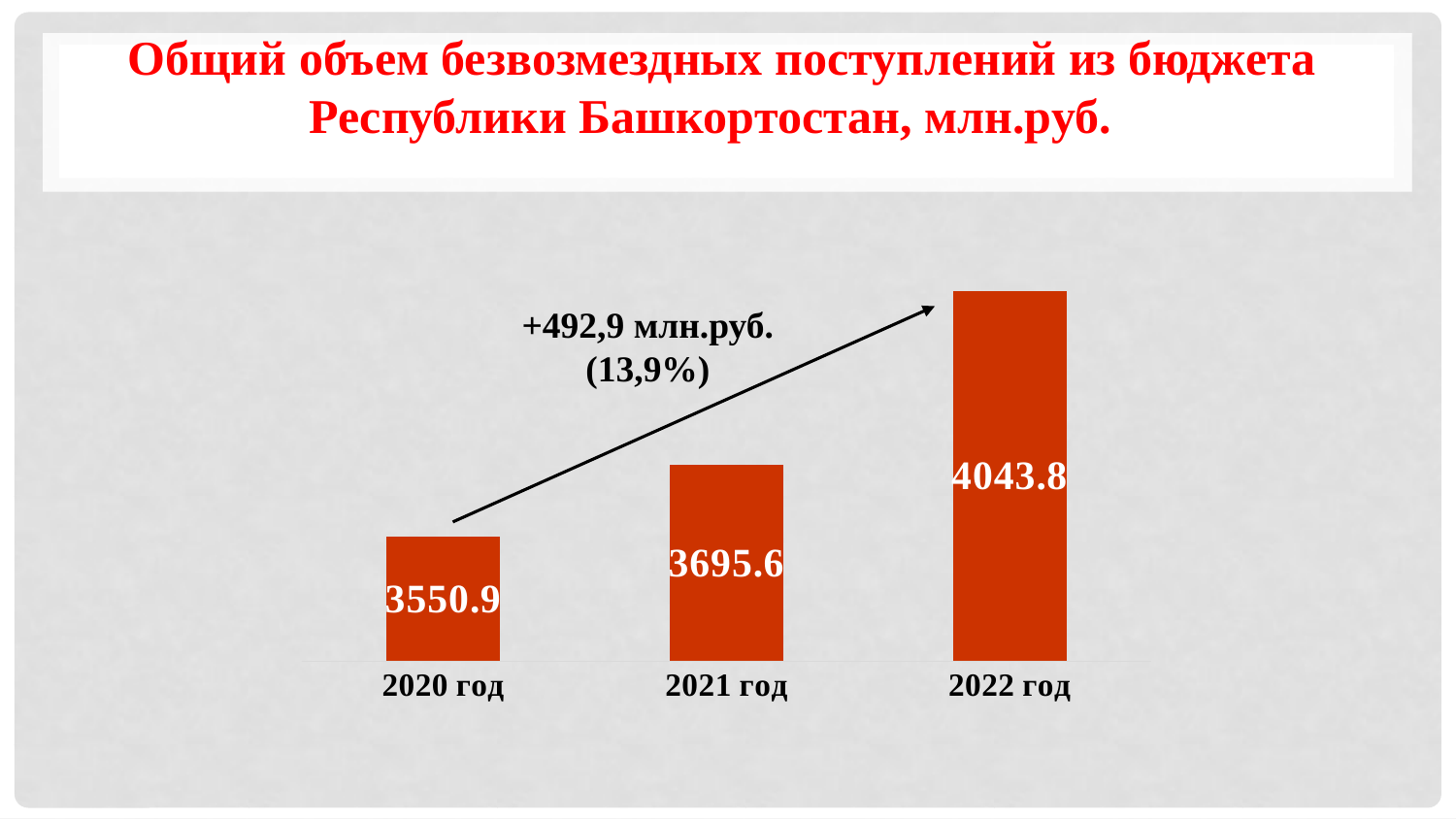
Which is larger, the value for 2021 год or the value for 2022 год? 2022 год Which year has the highest value? 2022 год What is the value for 2020 год? 3550.9 What type of chart is shown on the slide? bar chart What is the value for 2022 год? 4043.8 What is the difference between the values for 2021 год and 2020 год? 144.7 Which year has the lowest value? 2020 год What is the value for 2021 год? 3695.6 What is the difference between the values for 2022 год and 2020 год? 492.9 What is the difference between the values for 2022 год and 2021 год? 348.2 Do the values rise or fall from 2020 год to 2022 год? rise How many bars are shown in the chart? 3